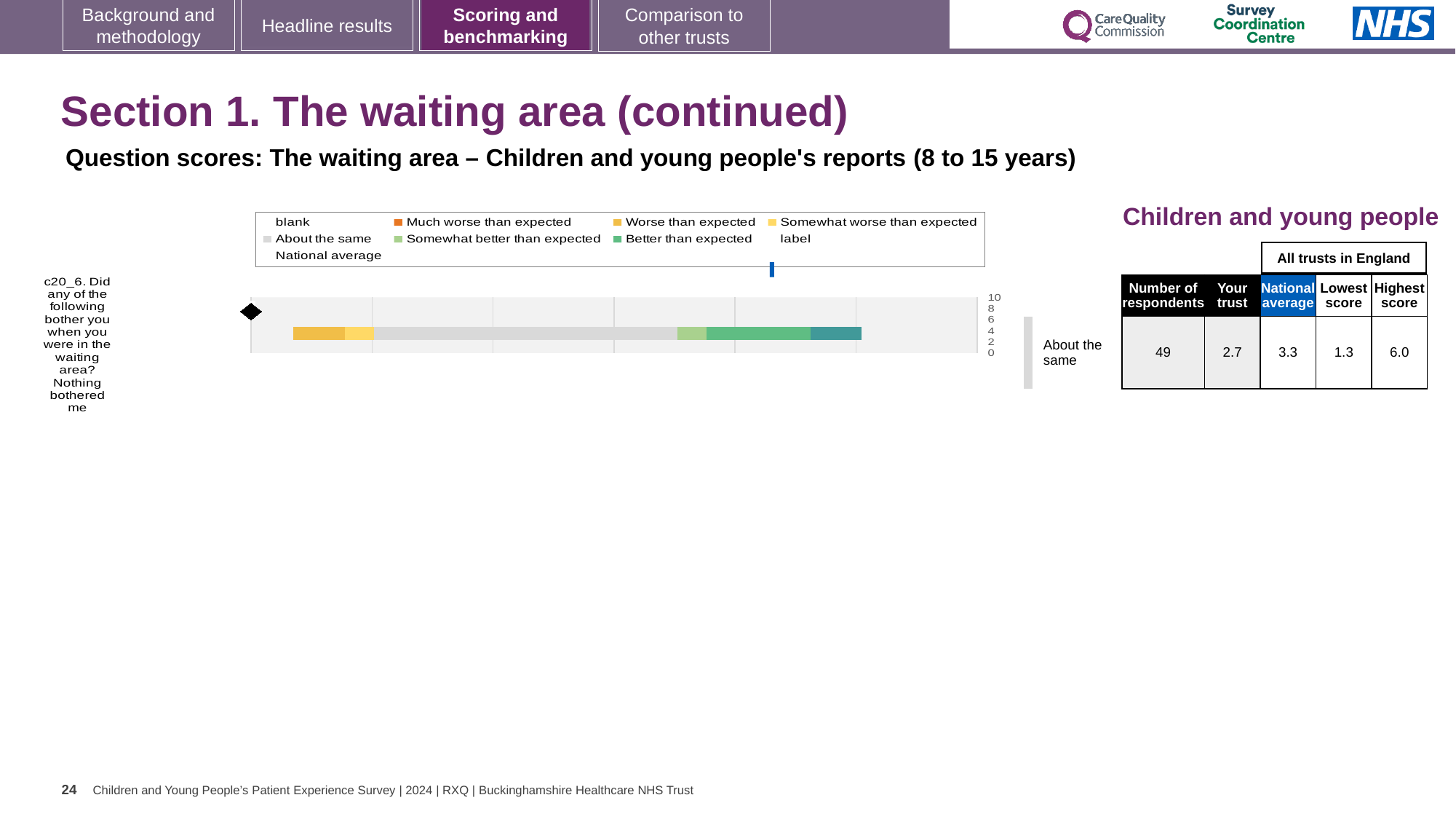
How many entries does the chart legend list? 9 In the table, what is the 'Your trust' score for question c20_6? 2.7 What is the difference between the highest score and the lowest score for question c20_6? 4.7 Which question is plotted in the bar chart? c20_6. Did any of the following bother you when you were in the waiting area? Nothing bothered me Which is larger for question c20_6: the 'Your trust' score or the national average? National average What benchmark category label is shown to the right of the bar for question c20_6? About the same How many question categories are plotted in the bar chart? 1 In the table, what is the highest score among all trusts in England for question c20_6? 6.0 In the table, what is the lowest score among all trusts in England for question c20_6? 1.3 In the table, what is the national average score for question c20_6? 3.3 In the table, what is the number of respondents for question c20_6? 49 What kind of chart is shown on the slide? Stacked bar chart